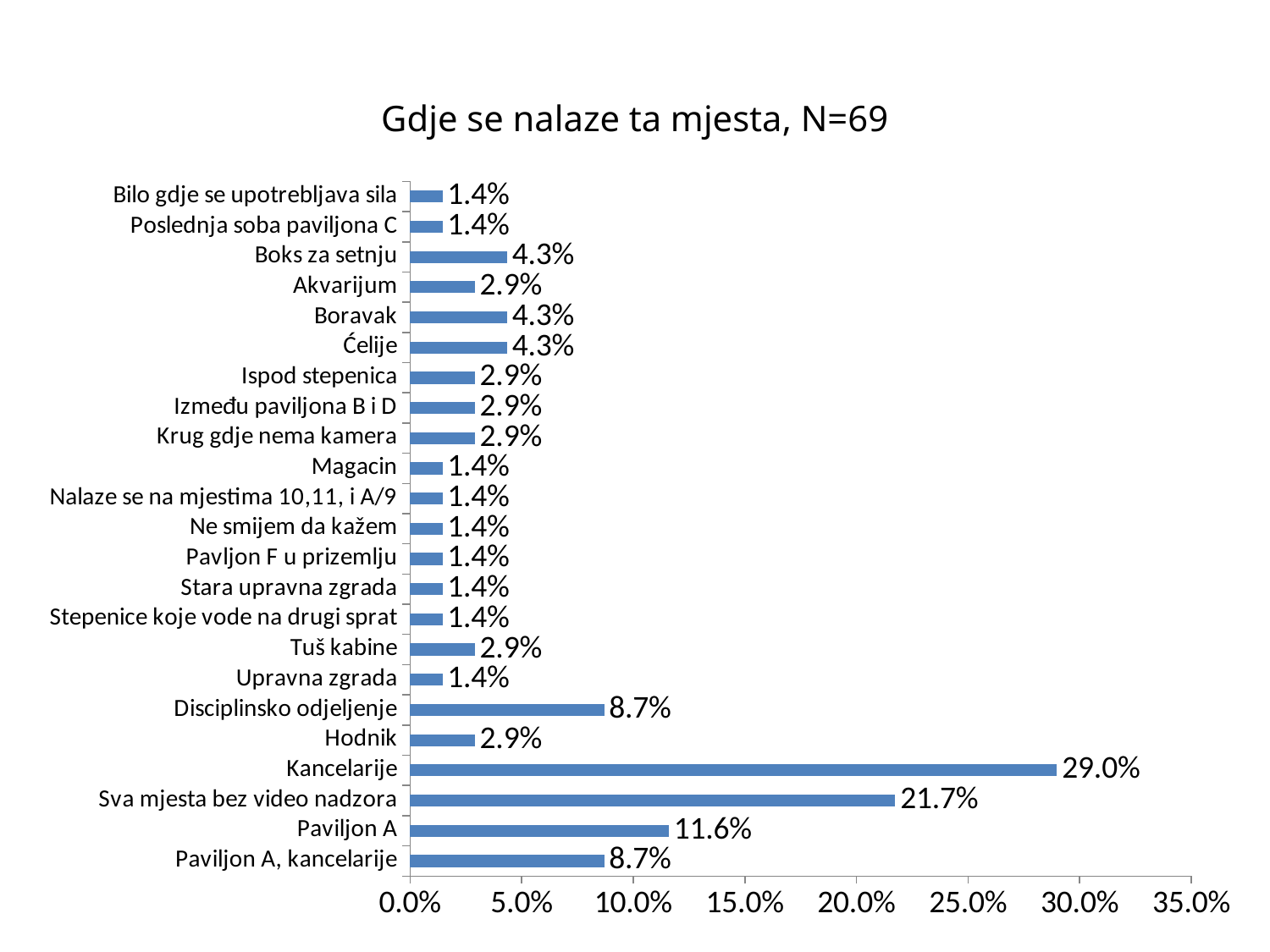
What is the value for Kancelarije? 29.0% What is the value for Disciplinsko odjeljenje? 8.7% Which category has the highest value? Kancelarije What is the value for Boks za setnju? 4.3% What is the difference between the values for Kancelarije and Sva mjesta bez video nadzora? 7.3% Is the value for Sva mjesta bez video nadzora greater or less than 20.0%? greater What is the value for Paviljon A? 11.6% What is the value for Sva mjesta bez video nadzora? 21.7% What is the difference between the values for Paviljon A and Paviljon A, kancelarije? 2.9% How many categories are shown in the chart? 23 Which is larger, the value for Boravak or the value for Akvarijum? Boravak What kind of chart is shown on the slide? Bar chart